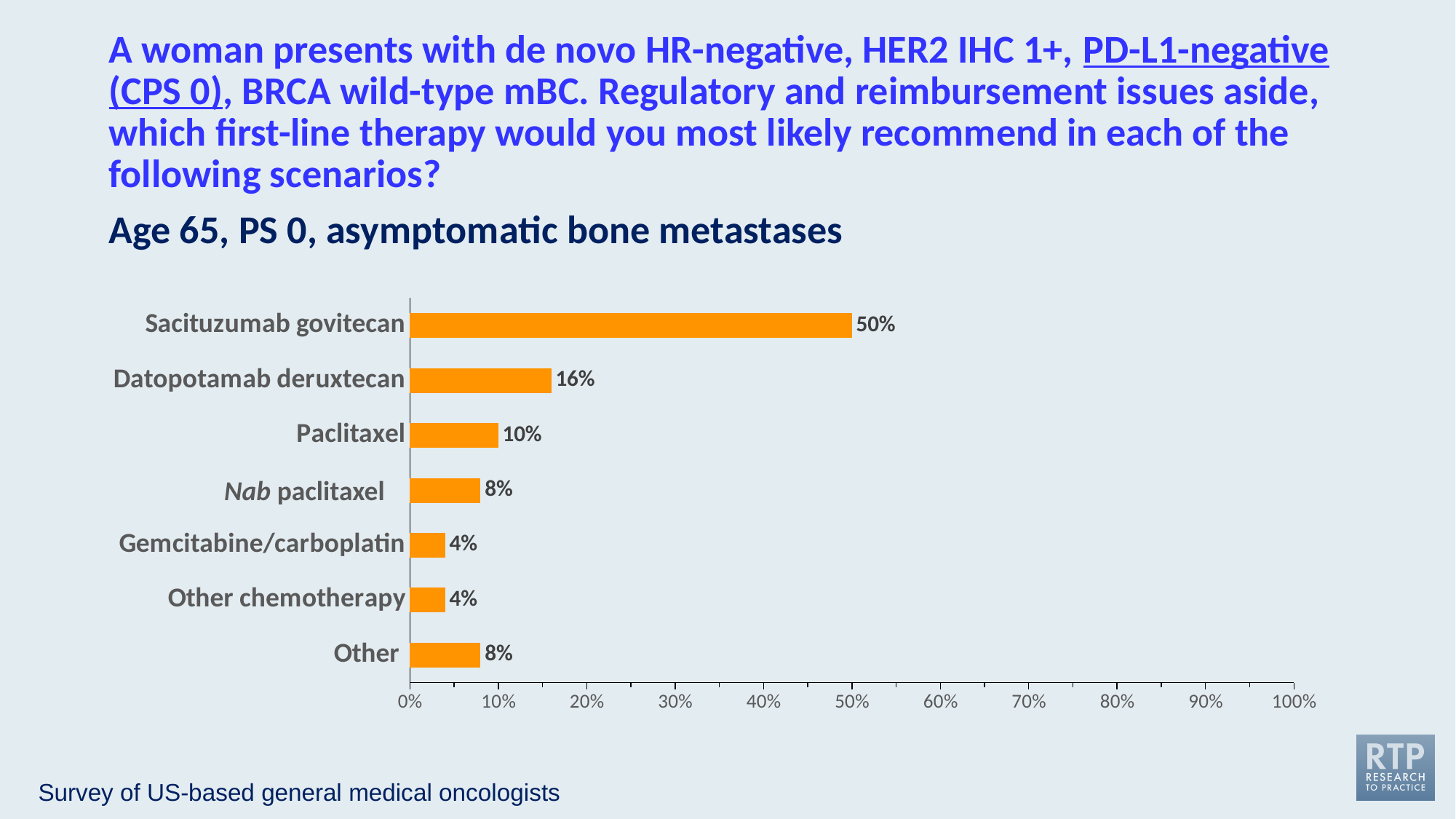
What kind of chart is shown on the slide? Bar chart Which has a larger percentage, Paclitaxel or Nab paclitaxel? Paclitaxel What percentage of respondents chose Gemcitabine/carboplatin? 4% What is the maximum value shown on the x axis? 100% What percentage of respondents chose Datopotamab deruxtecan? 16% What percentage of respondents chose Paclitaxel? 10% Which therapy has the highest percentage? Sacituzumab govitecan What percentage of respondents chose Sacituzumab govitecan? 50% Is the value for Sacituzumab govitecan greater or less than 40%? greater What is the difference in percentage points between Sacituzumab govitecan and Datopotamab deruxtecan? 34 How many therapy categories are shown in the chart? 7 What is the combined percentage for Gemcitabine/carboplatin and Other chemotherapy? 8%